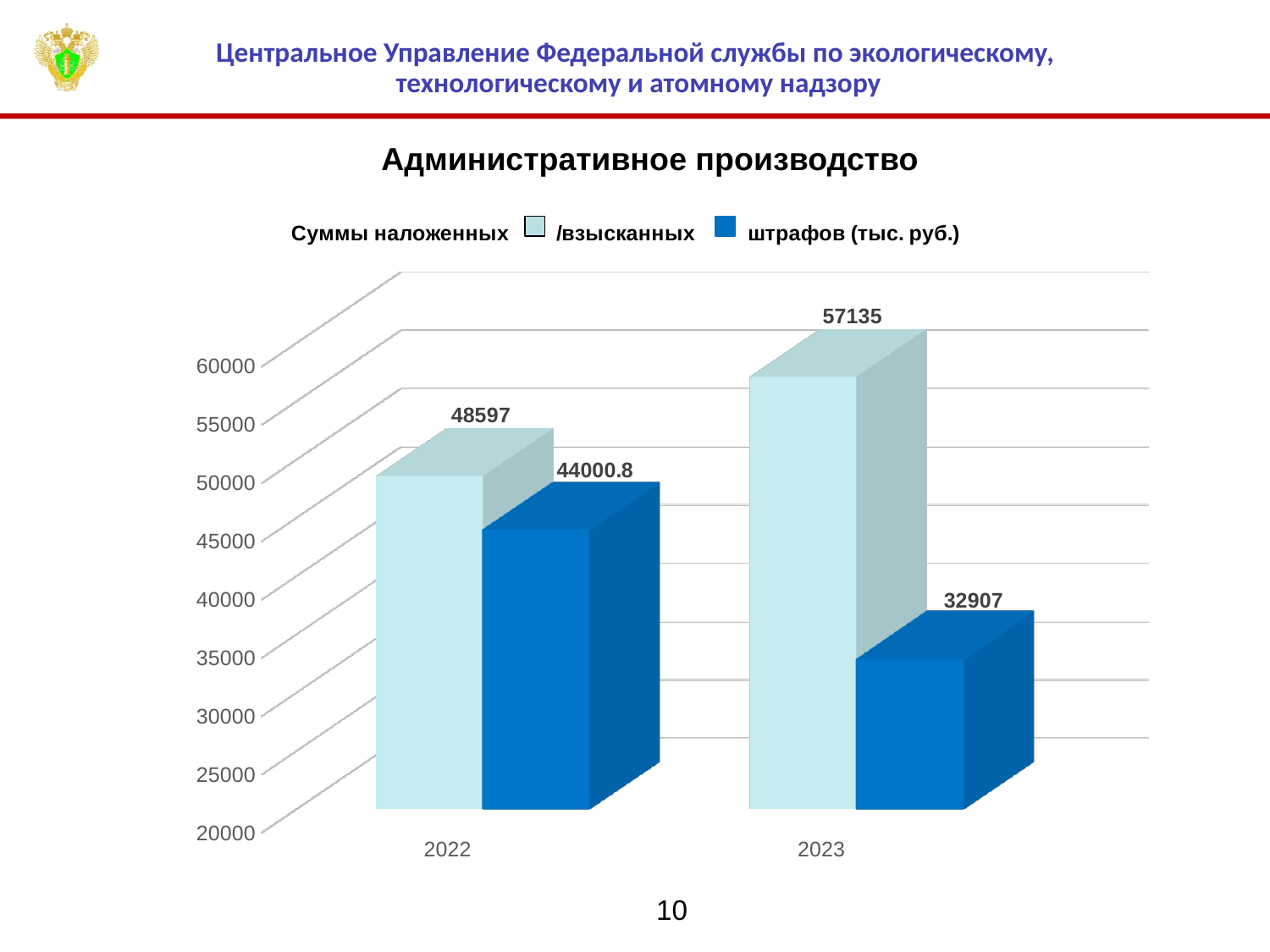
How many series does the legend list? 2 What kind of chart is shown on the slide? Bar chart What is the value of the imposed fines (наложенных) for 2023? 57135 Which year has the lowest value for collected fines (взысканных)? 2023 Which is larger: collected fines in 2022 or collected fines in 2023? Collected fines in 2022 How many years (categories) are shown on the x axis? 2 What is the value of the imposed fines (наложенных) for 2022? 48597 What is the value of the collected fines (взысканных) for 2022? 44000.8 Do the collected fines (взысканных) rise or fall from 2022 to 2023? Fall What is the value of the collected fines (взысканных) for 2023? 32907 What is the difference between imposed and collected fines in 2023? 24228 Which year has the highest value for imposed fines (наложенных)? 2023